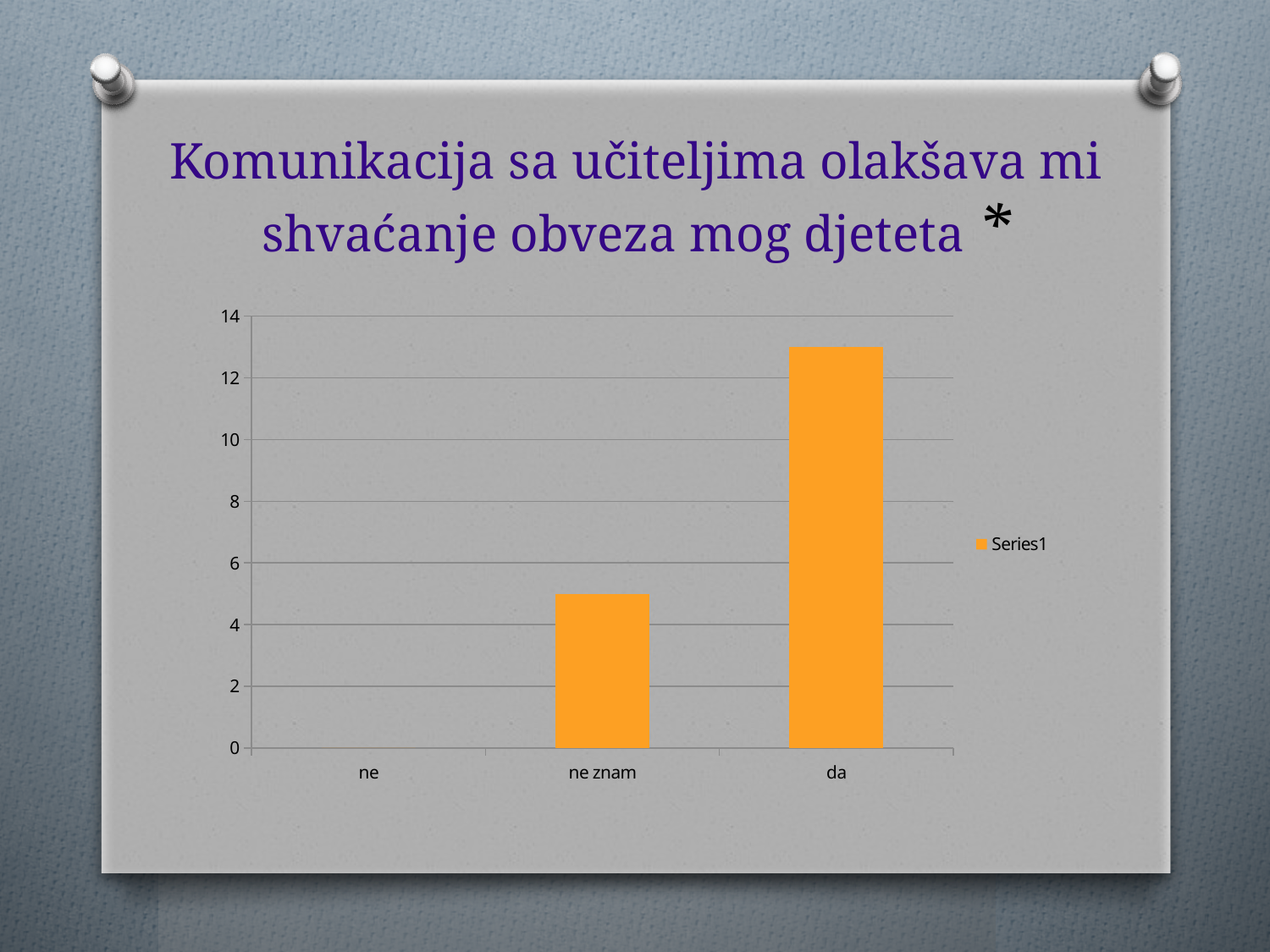
What colour are the bars in the chart? orange Which category has the lowest value in the chart? ne Which has the larger value, 'ne znam' or 'da'? da Is the value for 'da' greater or less than 14? less Is the value for 'da' greater or less than 12? greater What kind of chart is shown on the slide? bar chart Which category has the highest value in the chart? da How many categories are shown on the x axis of the chart? 3 Is the value for 'ne znam' greater or less than 6? less How many series does the chart legend list? 1 What is the name of the series shown in the chart legend? Series1